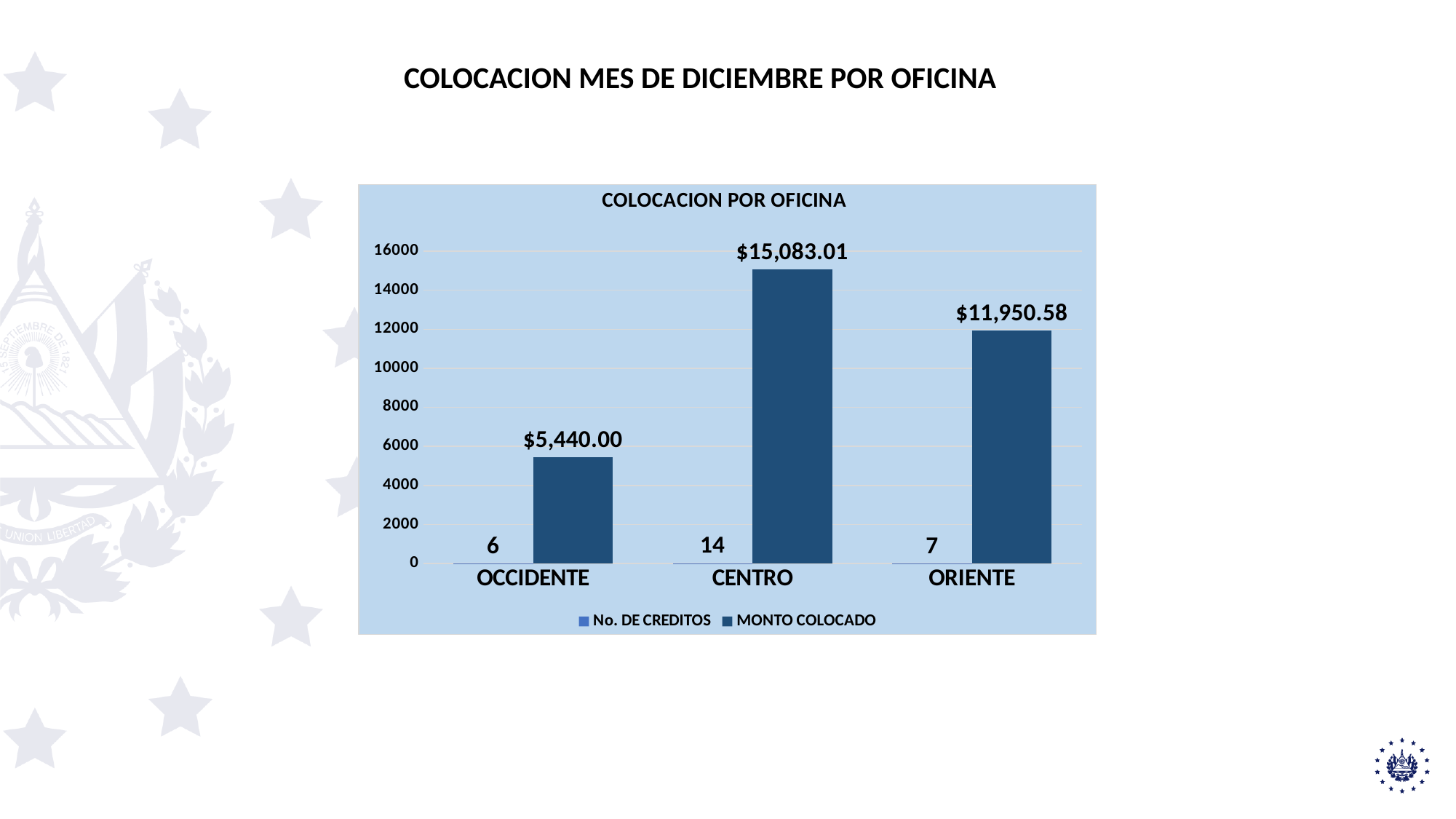
Which has a larger MONTO COLOCADO, ORIENTE or OCCIDENTE? ORIENTE How many series does the legend list? 2 How many credits (No. DE CREDITOS) does ORIENTE show? 7 How many offices are shown on the x axis? 3 How many more credits does CENTRO have than OCCIDENTE? 8 Is the MONTO COLOCADO for ORIENTE greater or less than 10000? greater Which office has the highest MONTO COLOCADO? CENTRO What is the MONTO COLOCADO for OCCIDENTE? $5,440.00 What is the MONTO COLOCADO for CENTRO? $15,083.01 What is the difference in MONTO COLOCADO between CENTRO and ORIENTE? $3,132.43 What type of chart is shown? Bar chart Which office has the lowest No. DE CREDITOS? OCCIDENTE